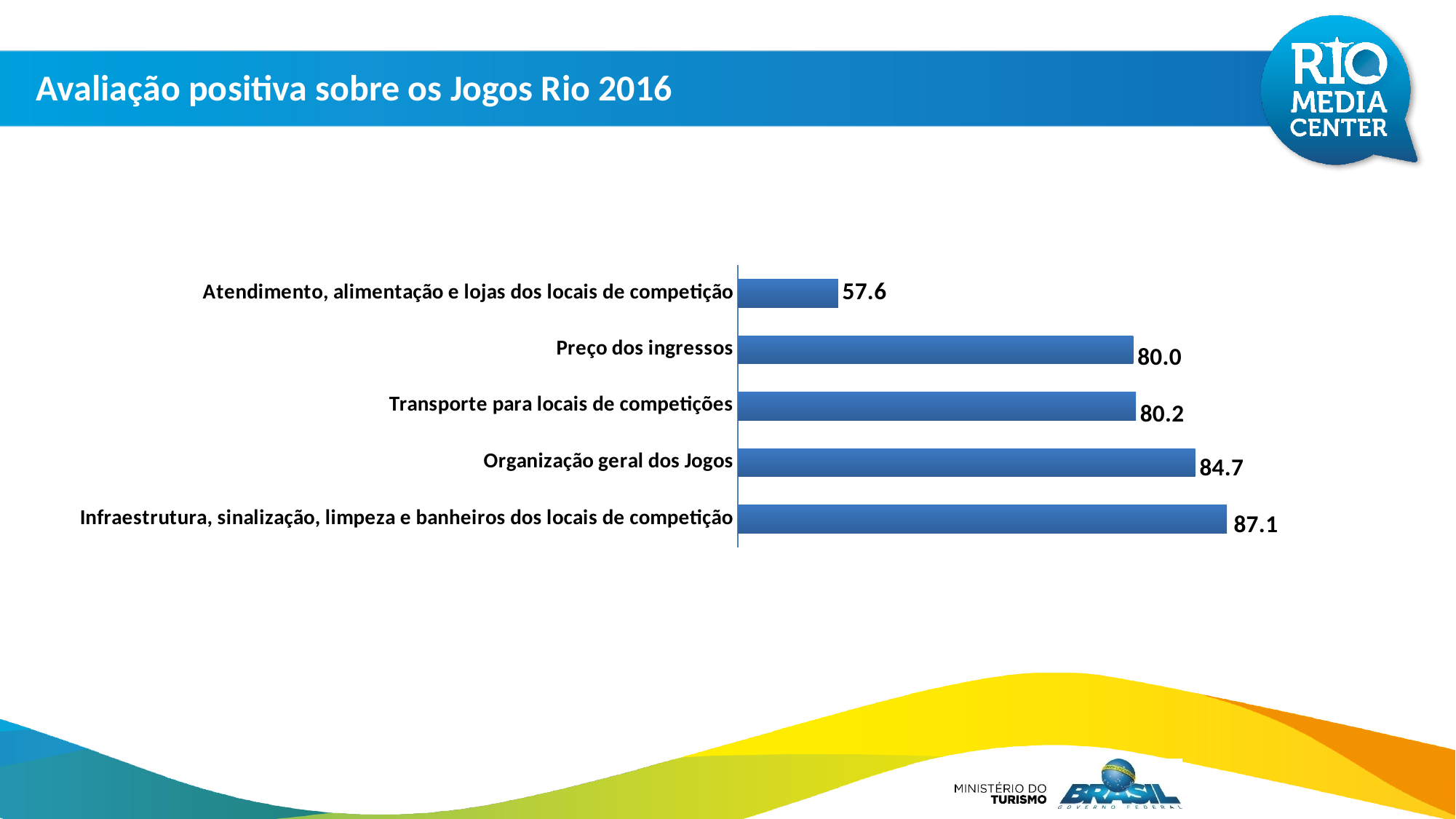
What is the value for "Organização geral dos Jogos"? 84.7 Which category has the highest value? Infraestrutura, sinalização, limpeza e banheiros dos locais de competição What is the difference between the values for "Infraestrutura, sinalização, limpeza e banheiros dos locais de competição" and "Atendimento, alimentação e lojas dos locais de competição"? 29.5 What is the difference between the values for "Organização geral dos Jogos" and "Preço dos ingressos"? 4.7 What is the value for "Transporte para locais de competições"? 80.2 What is the title of the slide containing the chart? Avaliação positiva sobre os Jogos Rio 2016 What kind of chart is shown on the slide? Bar chart Which is larger: the value for "Organização geral dos Jogos" or the value for "Preço dos ingressos"? Organização geral dos Jogos Which category has the lowest value? Atendimento, alimentação e lojas dos locais de competição How many categories are shown in the chart? 5 What is the value for "Atendimento, alimentação e lojas dos locais de competição"? 57.6 What is the value for "Preço dos ingressos"? 80.0